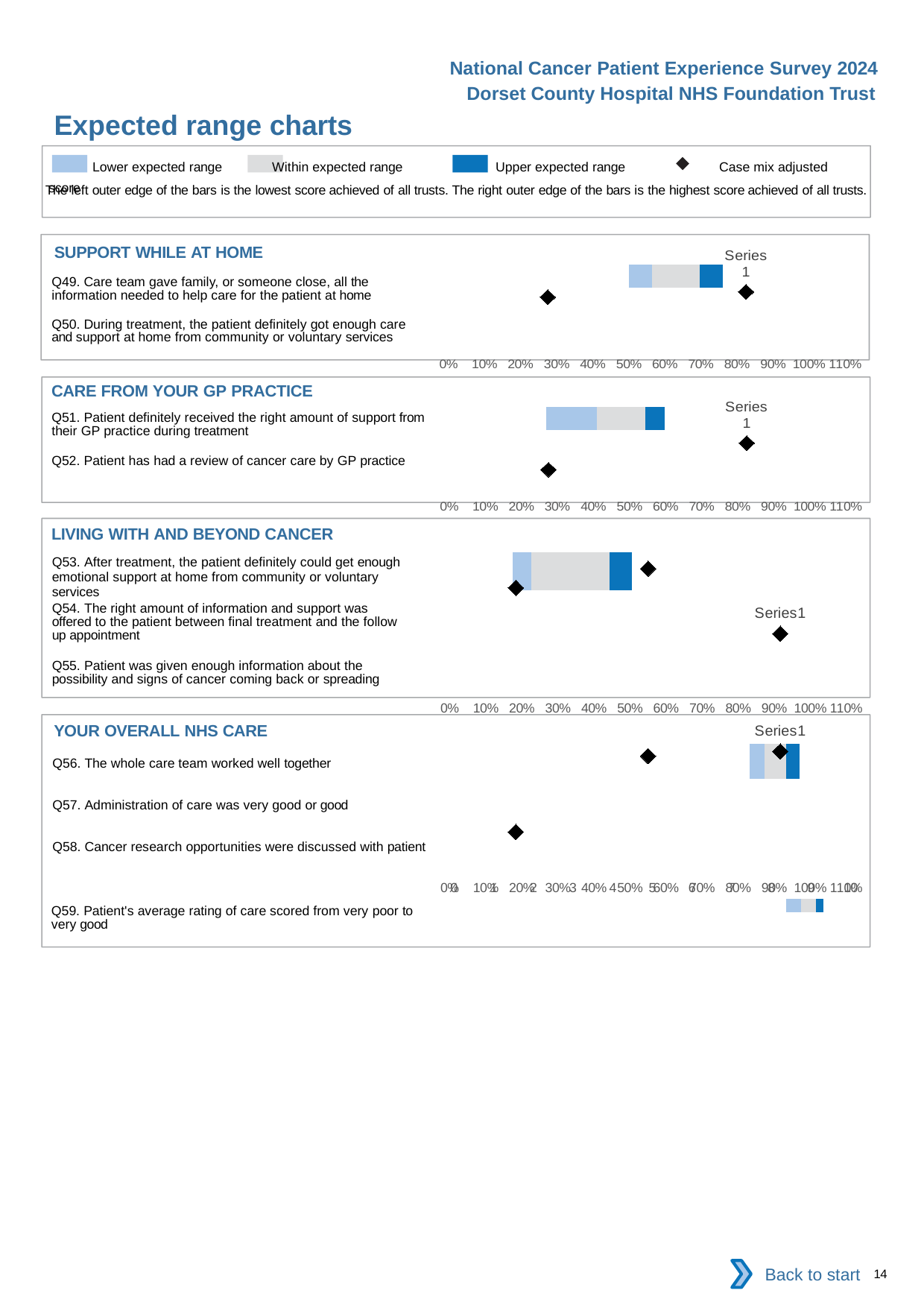
Which legend entry is shown in dark blue? Upper expected range How many questions are listed in the CARE FROM YOUR GP PRACTICE chart? 2 How many section charts are shown on the slide? 4 In the YOUR OVERALL NHS CARE chart, is the leftmost diamond marker greater or less than 30%? less How many questions are listed in the YOUR OVERALL NHS CARE chart? 4 In the SUPPORT WHILE AT HOME chart, is the leftmost diamond marker greater or less than 50%? less In the CARE FROM YOUR GP PRACTICE chart, is the rightmost diamond marker greater or less than 70%? greater What kind of chart is used in the expected range charts on this slide? bar chart How many entries does the legend at the top of the slide list? 4 Which legend entry is represented by a diamond marker? Case mix adjusted score